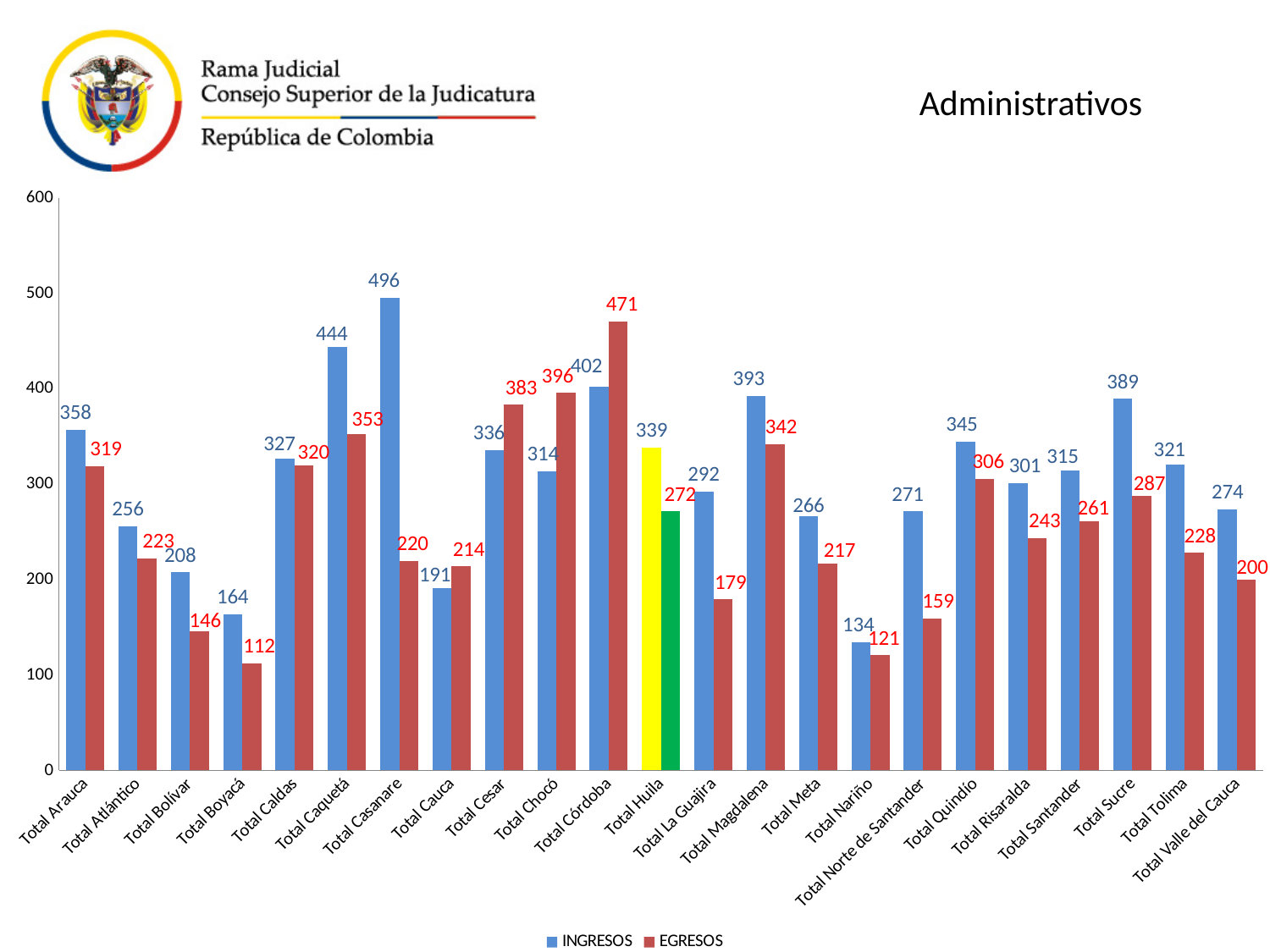
How many categories are shown on the x axis? 23 What is the difference between INGRESOS and EGRESOS for Total Casanare? 276 What is the EGRESOS value for Total Córdoba? 471 What is the EGRESOS value for Total Huila? 272 What kind of chart is shown on the slide? Bar chart How many series does the legend list? 2 Which is larger for Total Chocó, INGRESOS or EGRESOS? EGRESOS Which category has the lowest INGRESOS value? Total Nariño Which category has the lowest EGRESOS value? Total Boyacá What is the INGRESOS value for Total Casanare? 496 Which category has the highest INGRESOS value? Total Casanare What is the title shown above the chart? Administrativos